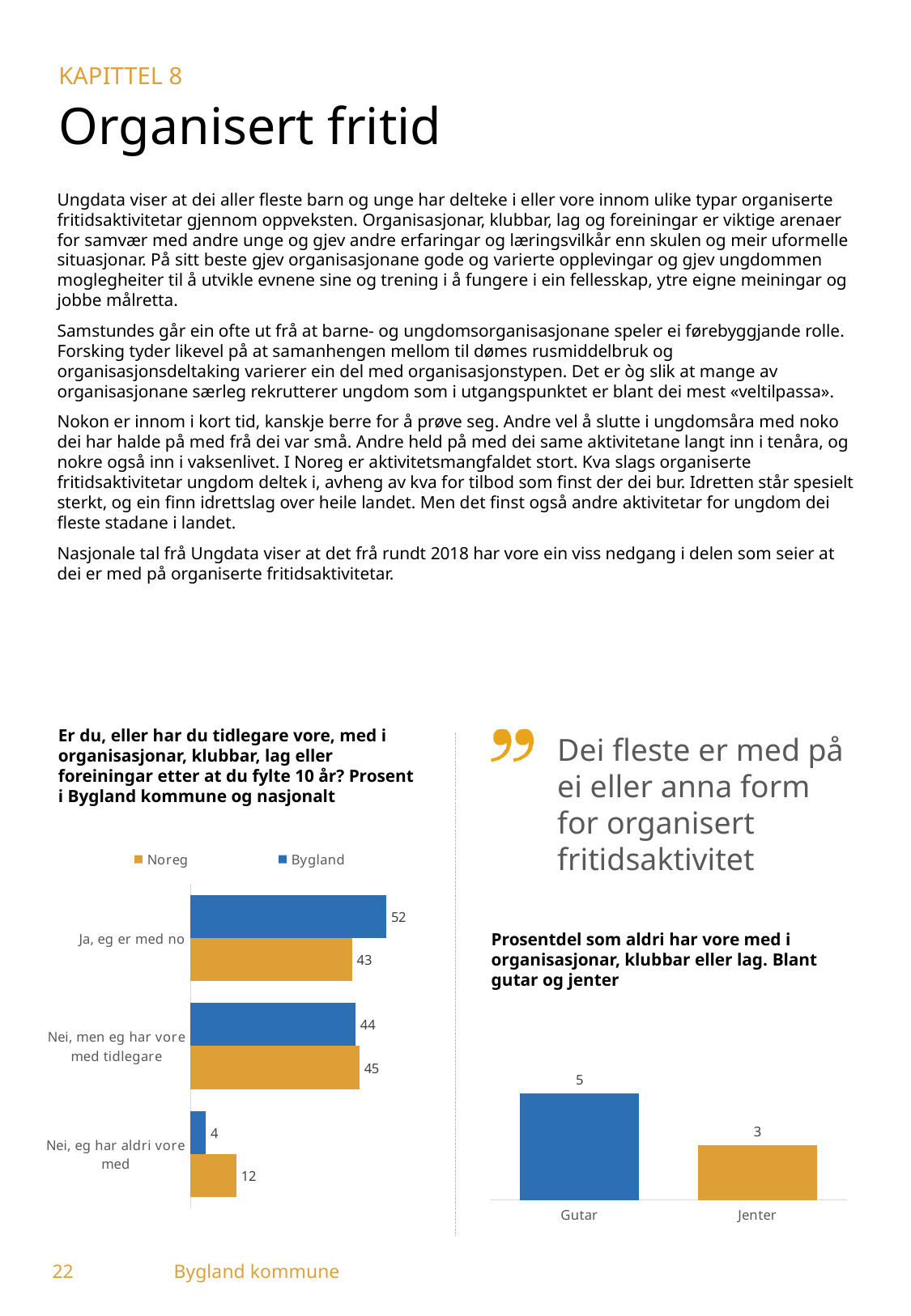
In the left chart, which category has the lowest value for Bygland? Nei, eg har aldri vore med In the left chart, which is larger for "Nei, eg har aldri vore med": Noreg or Bygland? Noreg In the left chart ("Er du, eller har du tidlegare vore, med i organisasjonar, klubbar, lag eller foreiningar..."), what is the value for Bygland for "Ja, eg er med no"? 52 In the right chart, what is the difference between Gutar and Jenter? 2 In the left chart, what is the value for Noreg for "Nei, eg har aldri vore med"? 12 In the right chart ("Prosentdel som aldri har vore med i organisasjonar, klubbar eller lag"), what is the value for Gutar? 5 How many series does the legend of the left chart list? 2 In the left chart, what is the difference between Bygland and Noreg for "Ja, eg er med no"? 9 In the right chart, which category has the highest value? Gutar How many categories are shown in the left chart? 3 What kind of chart is the left chart? Bar chart In the left chart, what is the value for Noreg for "Nei, men eg har vore med tidlegare"? 45